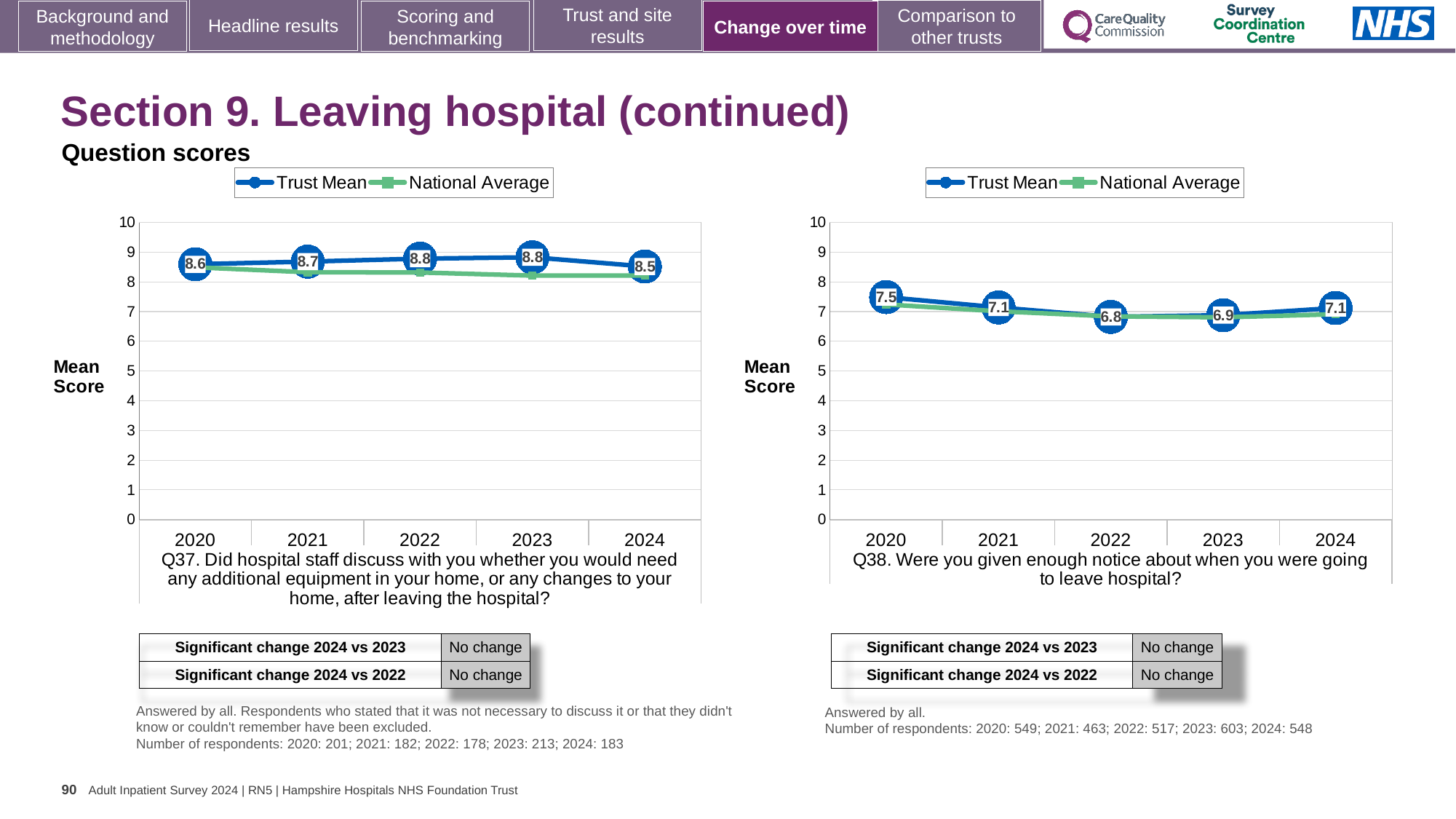
In the left chart (Q37), what is the difference between the Trust Mean scores for 2023 and 2024? 0.3 In the right chart (Q38), what is the Trust Mean score for 2022? 6.8 In the right chart (Q38), which year has the highest Trust Mean score? 2020 In the left chart (Q37), what is the Trust Mean score for 2024? 8.5 In the left chart (Q37), which year has the lowest Trust Mean score? 2024 In the right chart (Q38), is the Trust Mean score for 2021 greater or less than 8? less In the right chart (Q38), which year has the lowest Trust Mean score? 2022 In the right chart (Q38), what is the Trust Mean score for 2020? 7.5 How many series does the legend of the left chart (Q37) list? 2 In the right chart (Q38), what is the difference between the Trust Mean scores for 2020 and 2022? 0.7 In the left chart (Q37), what is the Trust Mean score for 2022? 8.8 What type of chart is used for Q38 on the right? Line chart